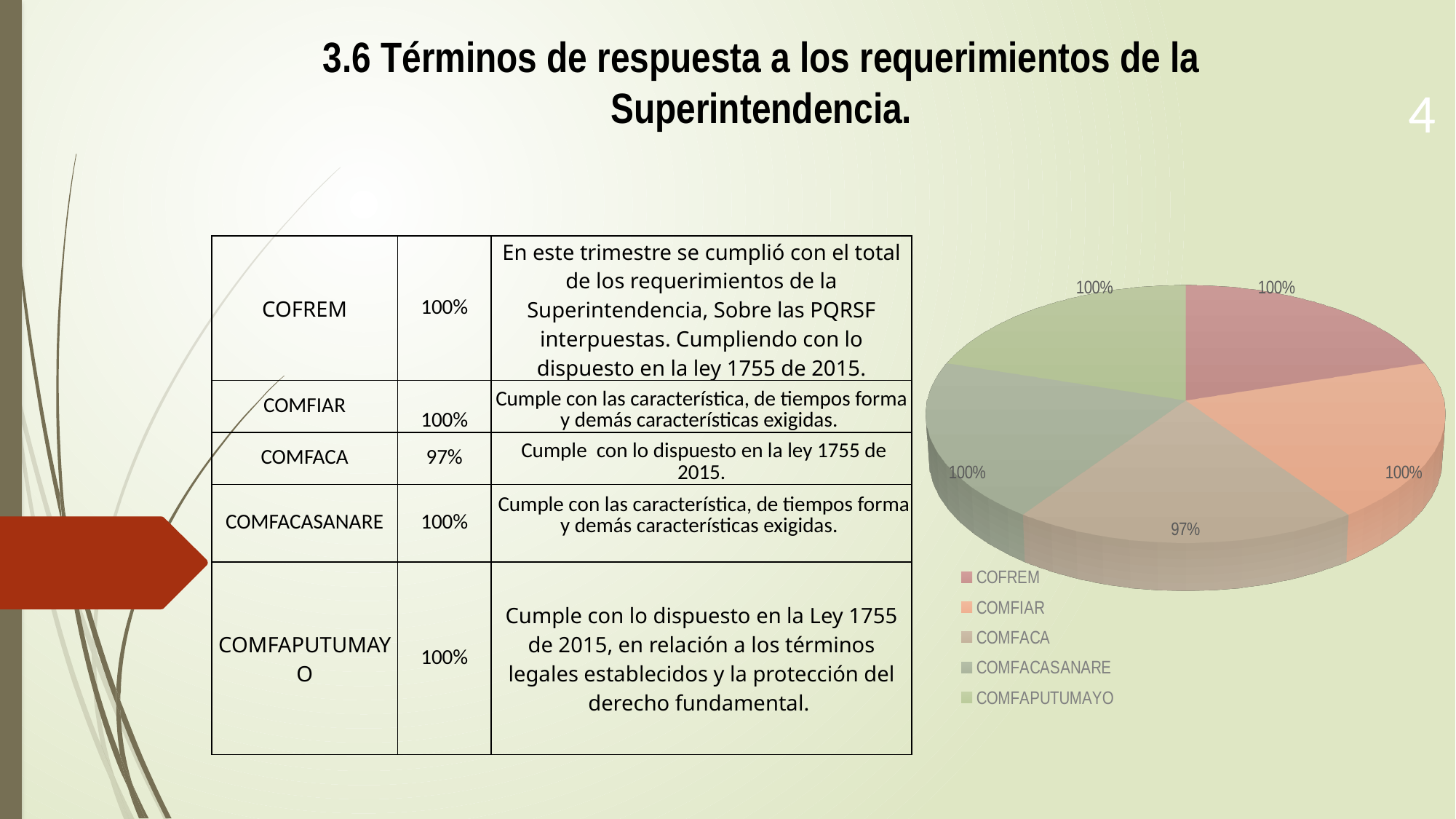
How many entries does the legend of the pie chart list? 5 Which legend entry is listed last in the pie chart's legend? COMFAPUTUMAYO What value is shown for COMFAPUTUMAYO in the pie chart? 100% Which is larger in the pie chart, the value for COMFIAR or the value for COMFACA? COMFIAR What value is shown for COFREM in the pie chart? 100% What kind of chart is shown on the slide? Pie chart Which category has the lowest value in the pie chart? COMFACA What value is shown for COMFACA in the pie chart? 97% What is the difference between the value for COMFACASANARE and the value for COMFACA in the pie chart? 3% Which legend entry is listed first in the pie chart's legend? COFREM How many slices does the pie chart have? 5